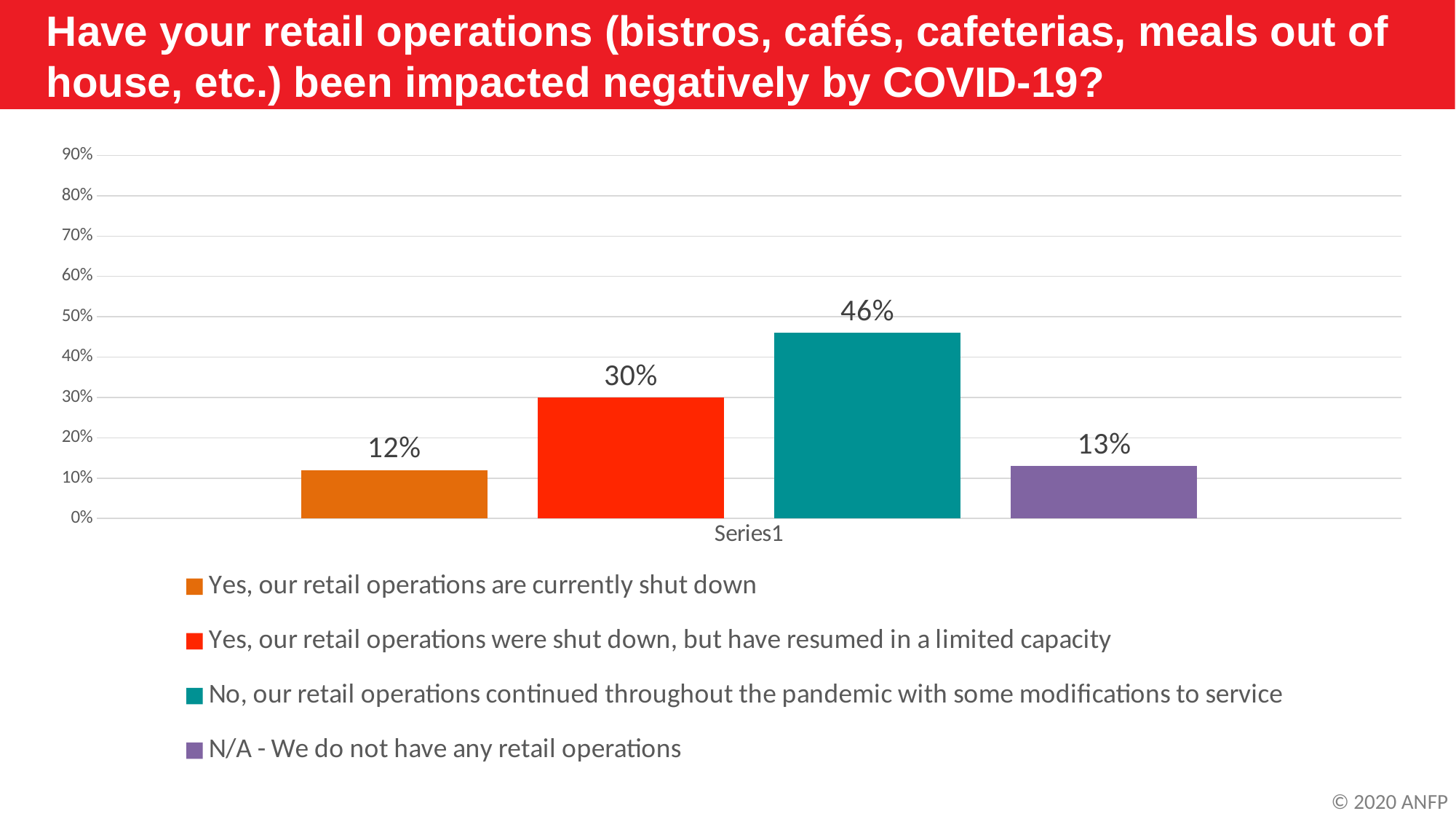
What percentage of respondents said they do not have any retail operations (N/A)? 13% What kind of chart is shown on the slide? Bar chart Is the value for 'No, our retail operations continued throughout the pandemic with some modifications to service' greater or less than 50%? less Which response has the highest percentage? No, our retail operations continued throughout the pandemic with some modifications to service What percentage of respondents said their retail operations are currently shut down? 12% What colour is the bar for 'N/A - We do not have any retail operations'? Purple What percentage of respondents said their retail operations were shut down but have resumed in a limited capacity? 30% Which is larger: the percentage for 'currently shut down' or the percentage for 'N/A - We do not have any retail operations'? N/A - We do not have any retail operations Which response has the lowest percentage? Yes, our retail operations are currently shut down What is the difference in percentage points between the 'continued throughout the pandemic' response and the 'resumed in a limited capacity' response? 16 percentage points What percentage of respondents said their retail operations continued throughout the pandemic with some modifications to service? 46% How many bars are shown in the chart? 4